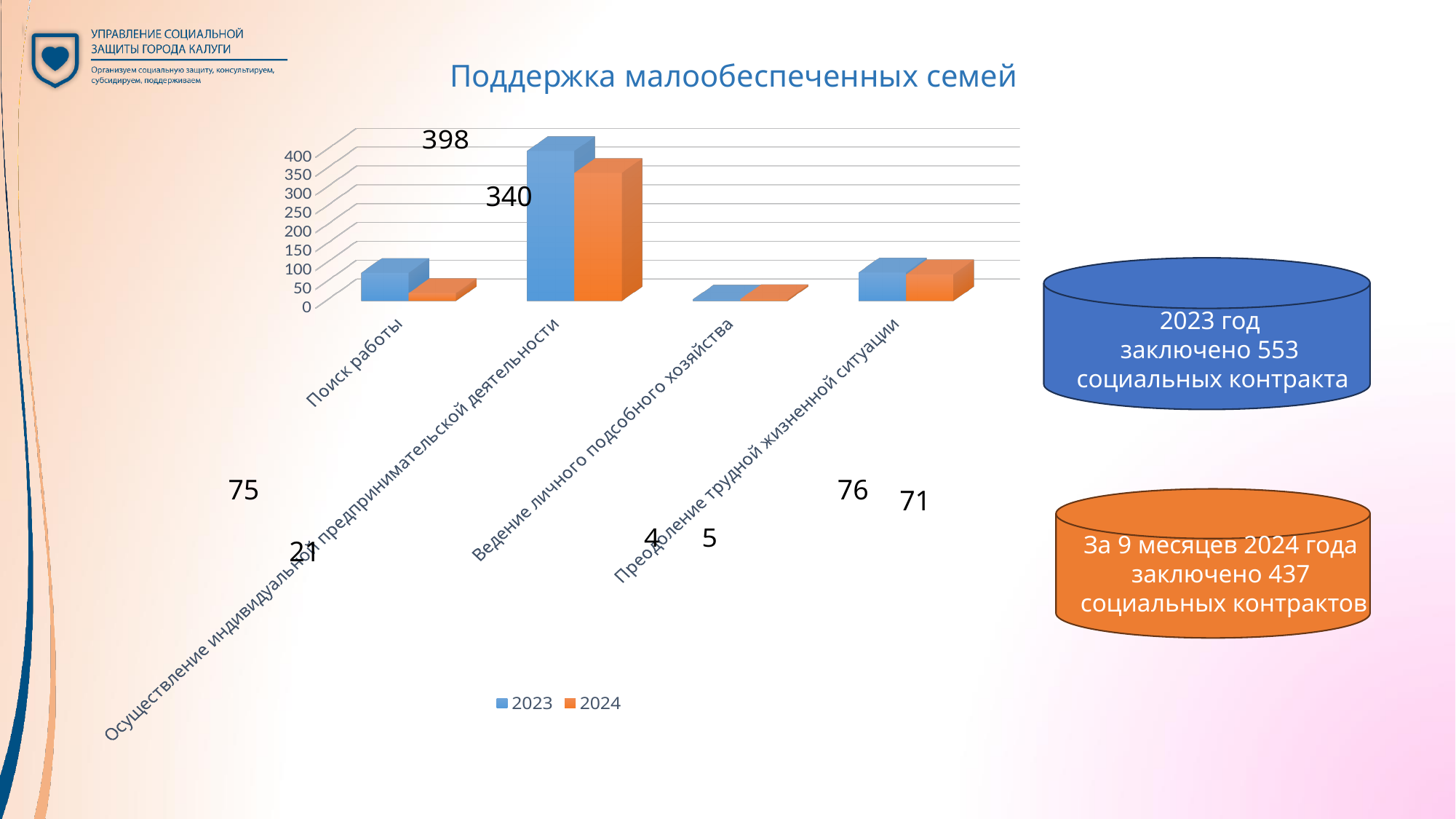
What is the title of the chart? Поддержка малообеспеченных семей What is the 2024 value for Преодоление трудной жизненной ситуации? 71 Is the 2023 value for Осуществление индивидуальной предпринимательской деятельности greater or less than 350? greater What is the 2024 value for Осуществление индивидуальной предпринимательской деятельности? 340 What is the 2023 value for Осуществление индивидуальной предпринимательской деятельности? 398 How many series does the chart legend list? 2 Which category has the highest 2023 value? Осуществление индивидуальной предпринимательской деятельности What kind of chart is shown on the slide? bar chart Which category has the lowest 2024 value? Ведение личного подсобного хозяйства What is the 2023 value for Поиск работы? 75 How many categories are shown on the x axis of the chart? 4 What is the difference between the 2023 and 2024 values for Осуществление индивидуальной предпринимательской деятельности? 58